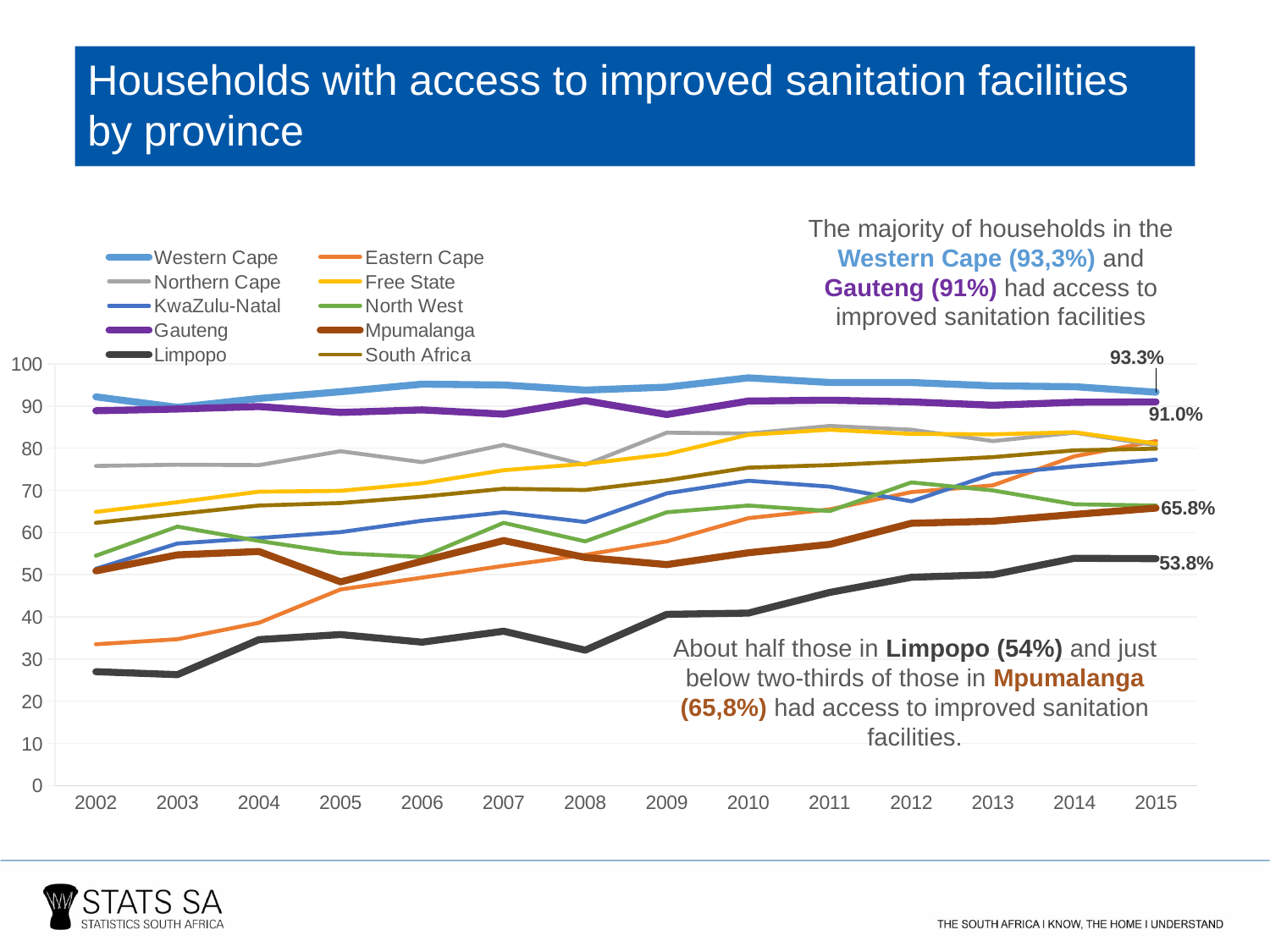
What is the difference between the Western Cape and Limpopo values in 2015? 39.5 percentage points Which province has the lowest value in 2015? Limpopo What is the value for Western Cape in 2015? 93.3% Does the Limpopo line generally rise or fall from 2002 to 2015? Rise What is the value for Gauteng in 2015? 91.0% How many years are shown on the x axis? 14 What is the value for Limpopo in 2015? 53.8% How many series does the legend list? 10 Which province has the highest value in 2015? Western Cape What kind of chart is shown on the slide? Line chart Is the value for Limpopo in 2002 greater or less than 30? less What is the value for Mpumalanga in 2015? 65.8%